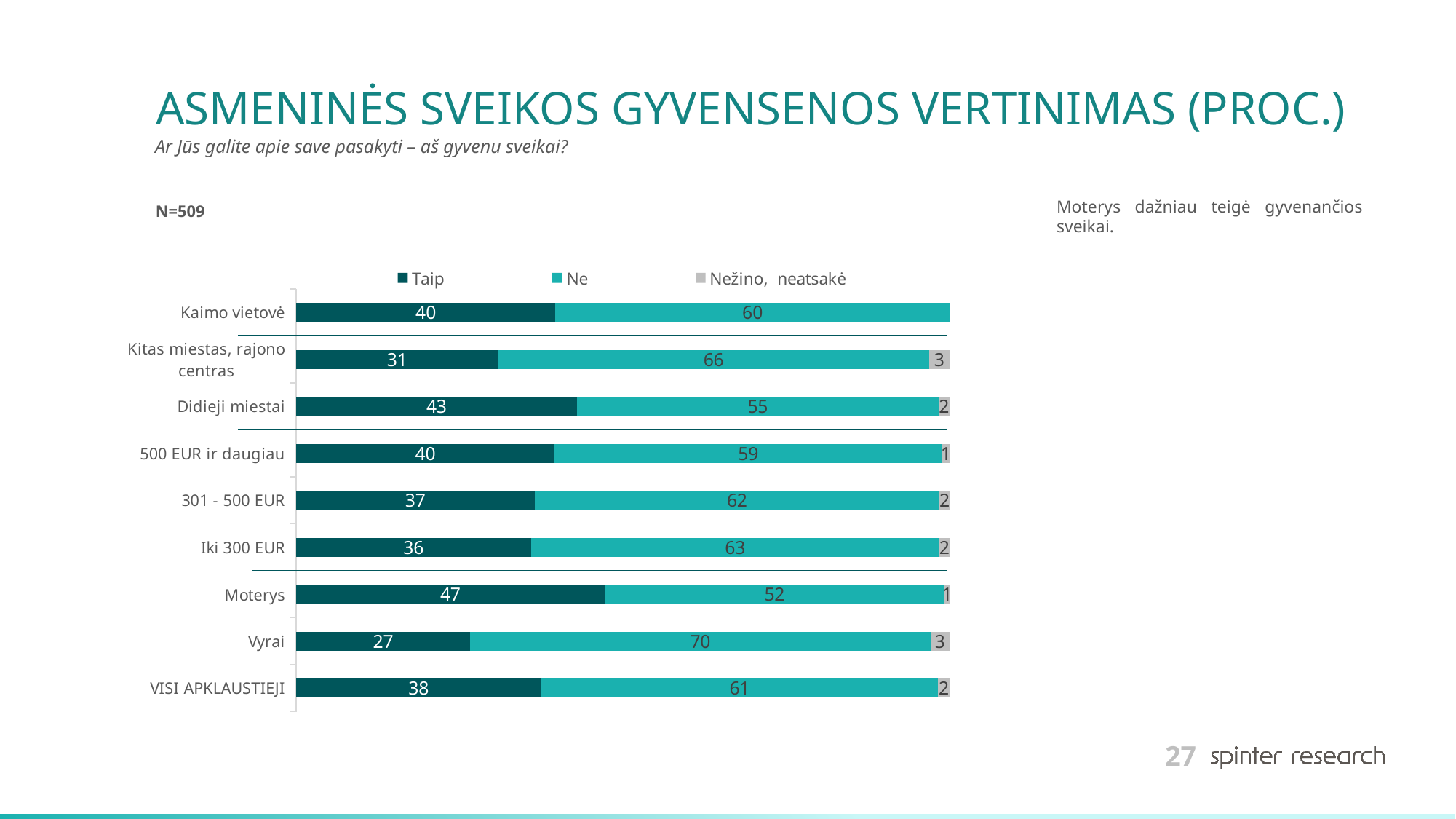
What kind of chart is shown on the slide? Stacked bar chart Which category has the lowest "Taip" value? Vyrai What is the difference between the "Taip" values for Moterys and Vyrai? 20 Which has a larger "Ne" value, Iki 300 EUR or 301 - 500 EUR? Iki 300 EUR Which category has the highest "Taip" value? Moterys What is the "Ne" value for Vyrai? 70 How many series does the legend list? 3 What is the "Nežino, neatsakė" value for Kitas miestas, rajono centras? 3 What is the "Taip" value for Moterys? 47 What is the total of the stacked bar for Didieji miestai? 100 How many categories are shown on the chart? 9 What is the "Taip" value for VISI APKLAUSTIEJI? 38